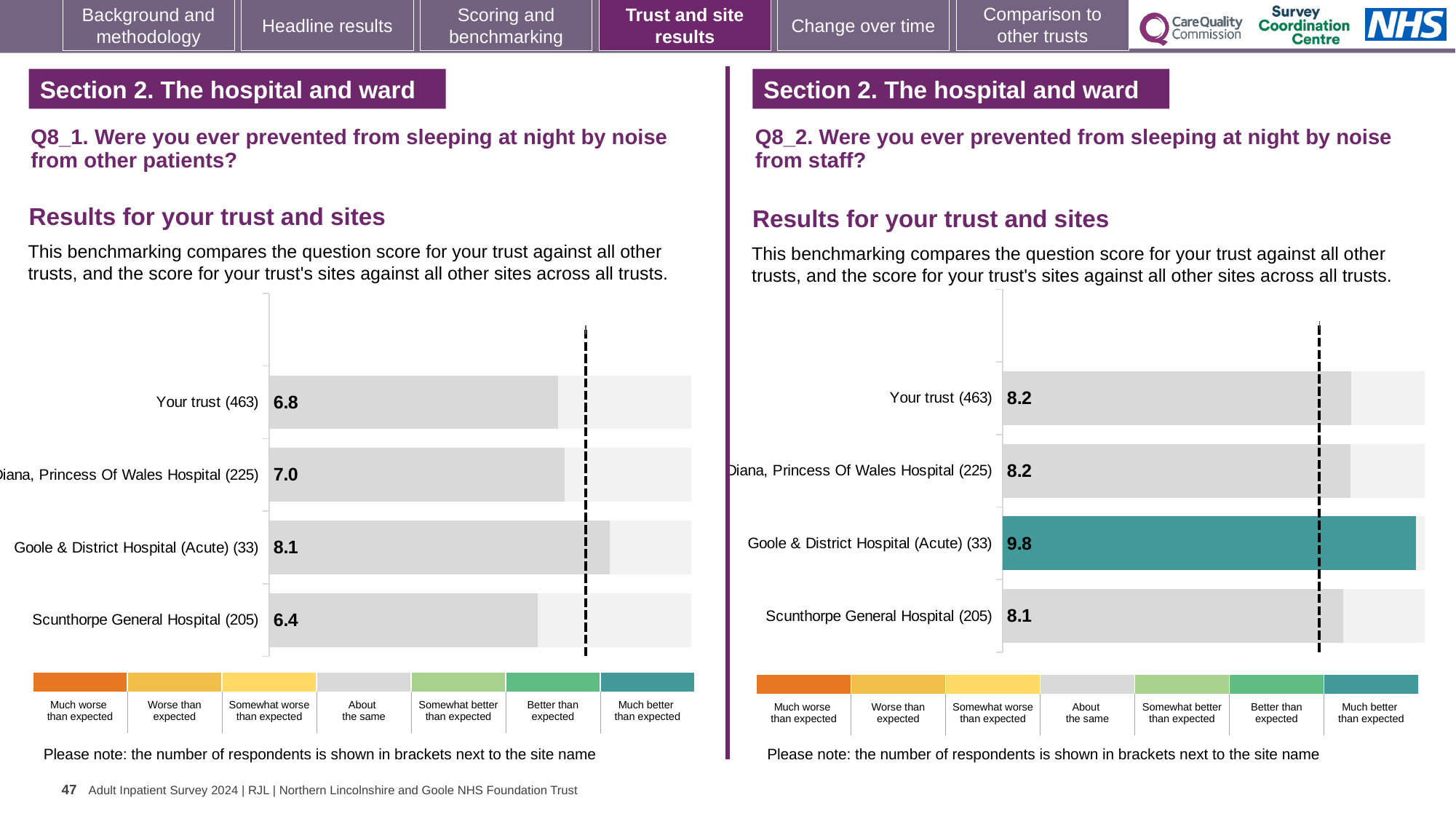
On the Q8_1 chart (noise from other patients), which site has the highest score? Goole & District Hospital (Acute) Which is larger: the Your trust score on the Q8_1 chart or the Your trust score on the Q8_2 chart? Q8_2 chart How many bars are shown on the Q8_1 chart (noise from other patients)? 4 On the Q8_2 chart (noise from staff), which site has the highest score? Goole & District Hospital (Acute) On the Q8_1 chart (noise from other patients), what is the score for Your trust? 6.8 On the Q8_2 chart (noise from staff), what is the score for Goole & District Hospital (Acute)? 9.8 On the Q8_1 chart (noise from other patients), which site has the lowest score? Scunthorpe General Hospital On the Q8_1 chart (noise from other patients), what is the score for Scunthorpe General Hospital? 6.4 On the Q8_1 chart (noise from other patients), what is the difference between the scores for Goole & District Hospital (Acute) and Scunthorpe General Hospital? 1.7 On the Q8_2 chart (noise from staff), what is the difference between the scores for Goole & District Hospital (Acute) and Your trust? 1.6 What type of chart is used on the Q8_2 chart (noise from staff)? Bar chart On the Q8_2 chart (noise from staff), what is the score for Diana, Princess Of Wales Hospital? 8.2